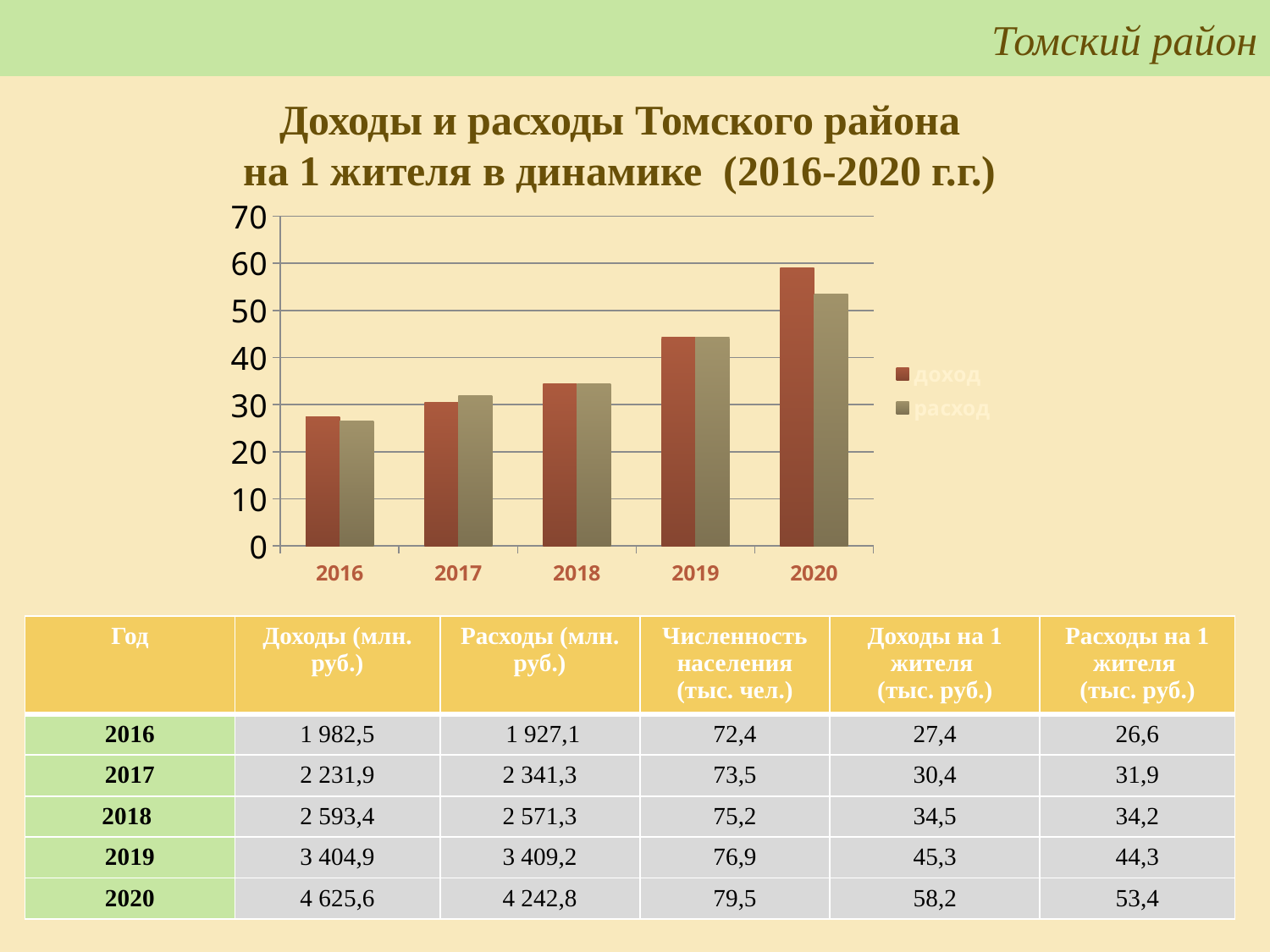
In 2020, which is larger in the chart: доход or расход? доход Which year has the highest value for доход in the chart? 2020 Which year has the lowest value for доход in the chart? 2016 How many years are shown on the x axis of the chart? 5 According to the table, what is the value of Доходы на 1 жителя (тыс. руб.) for 2020? 58,2 Is the value for расход in 2016 greater or less than 30? less Is the value for доход in 2020 greater or less than 50? greater What kind of chart is shown on the slide? bar chart What are the two entries in the chart legend? доход, расход Do the доход values rise or fall from 2016 to 2020? rise Using the table values, what is the difference between Доходы на 1 жителя and Расходы на 1 жителя in 2020? 4,8 How many series does the chart legend list? 2